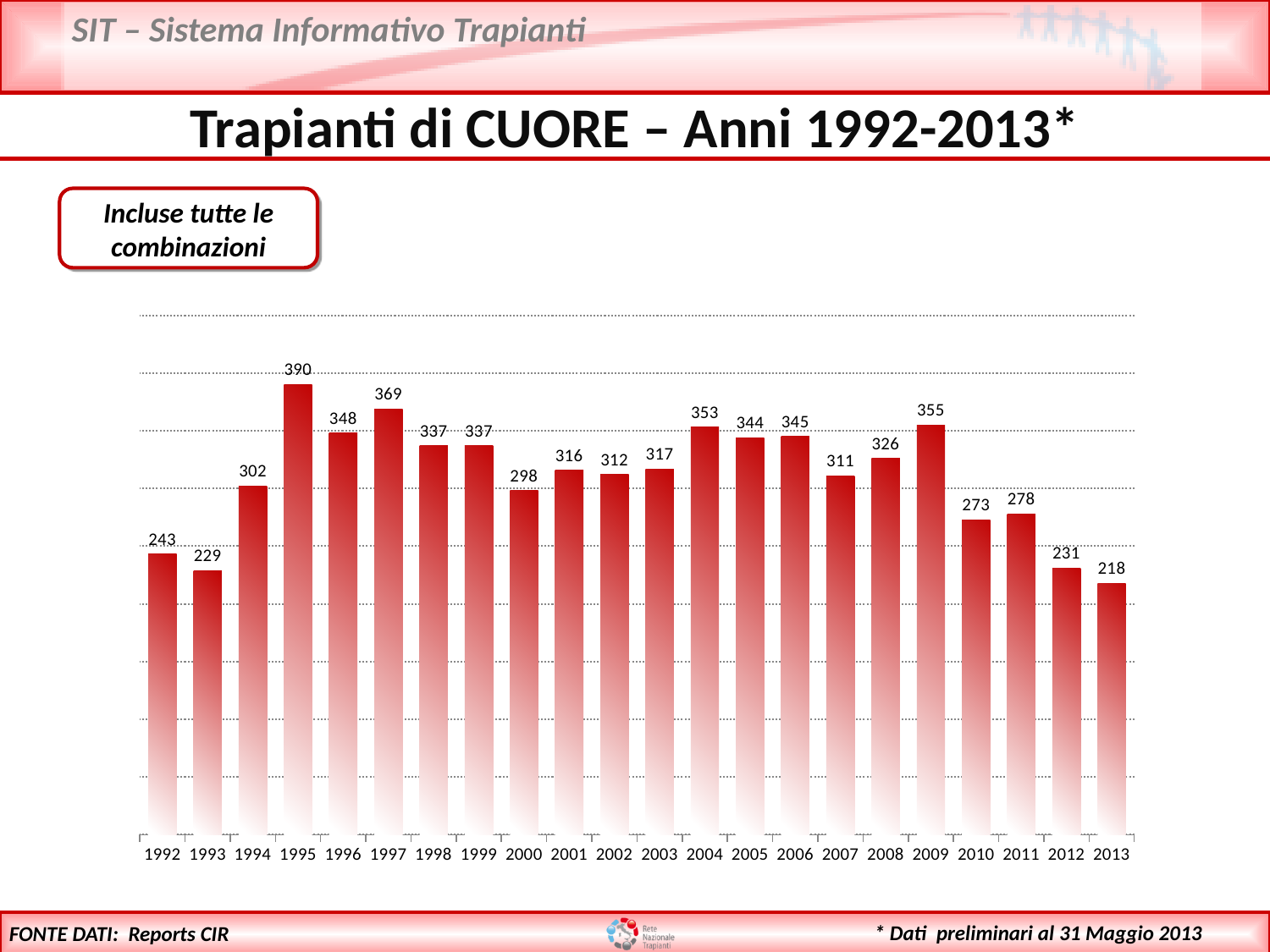
Do the values rise or fall from 2009 to 2013? Fall Which is larger, the value for 1997 or the value for 2009? 1997 What is the difference between the values for 2009 and 2010? 82 Which is larger, the value for 1992 or the value for 2012? 1992 How many years are shown on the x axis? 22 What is the value for 1995? 390 What is the difference between the values for 1995 and 2013? 172 Which year has the highest value? 1995 What is the value for 2004? 353 Which year has the lowest value? 2013 What is the value for 2013? 218 What kind of chart is shown on the slide? Bar chart